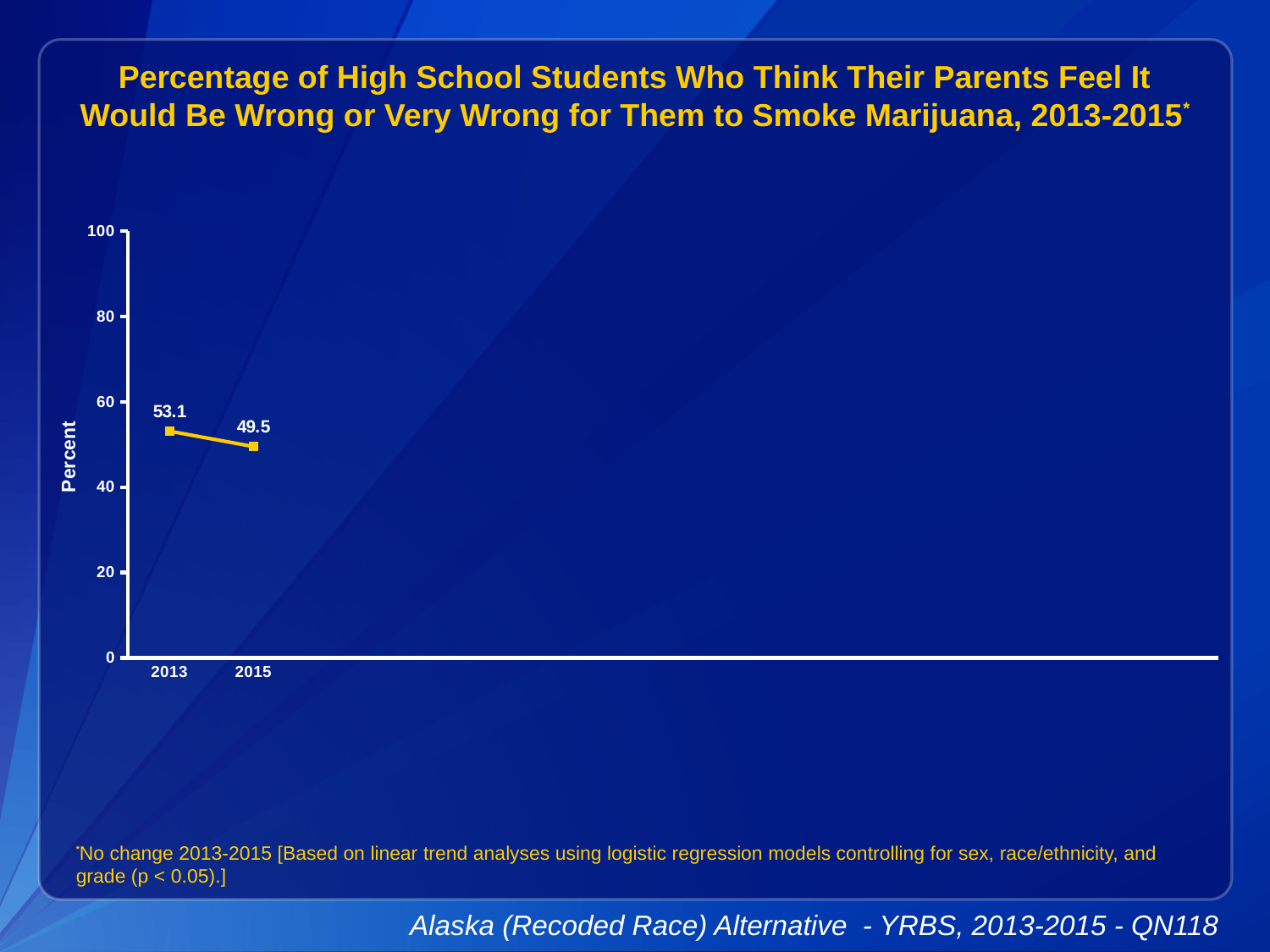
Which year has the lowest value? 2015 What kind of chart is shown? line chart Which is larger, the value for 2013 or the value for 2015? 2013 How many data points are plotted on the chart? 2 Which year has the highest value? 2013 Do the values rise or fall from 2013 to 2015? fall What is the value for 2013? 53.1 What is the label on the y axis? Percent Is the value for 2013 greater or less than 40? greater What is the value for 2015? 49.5 Is the value for 2015 greater or less than 60? less What is the difference between the 2013 and 2015 values? 3.6